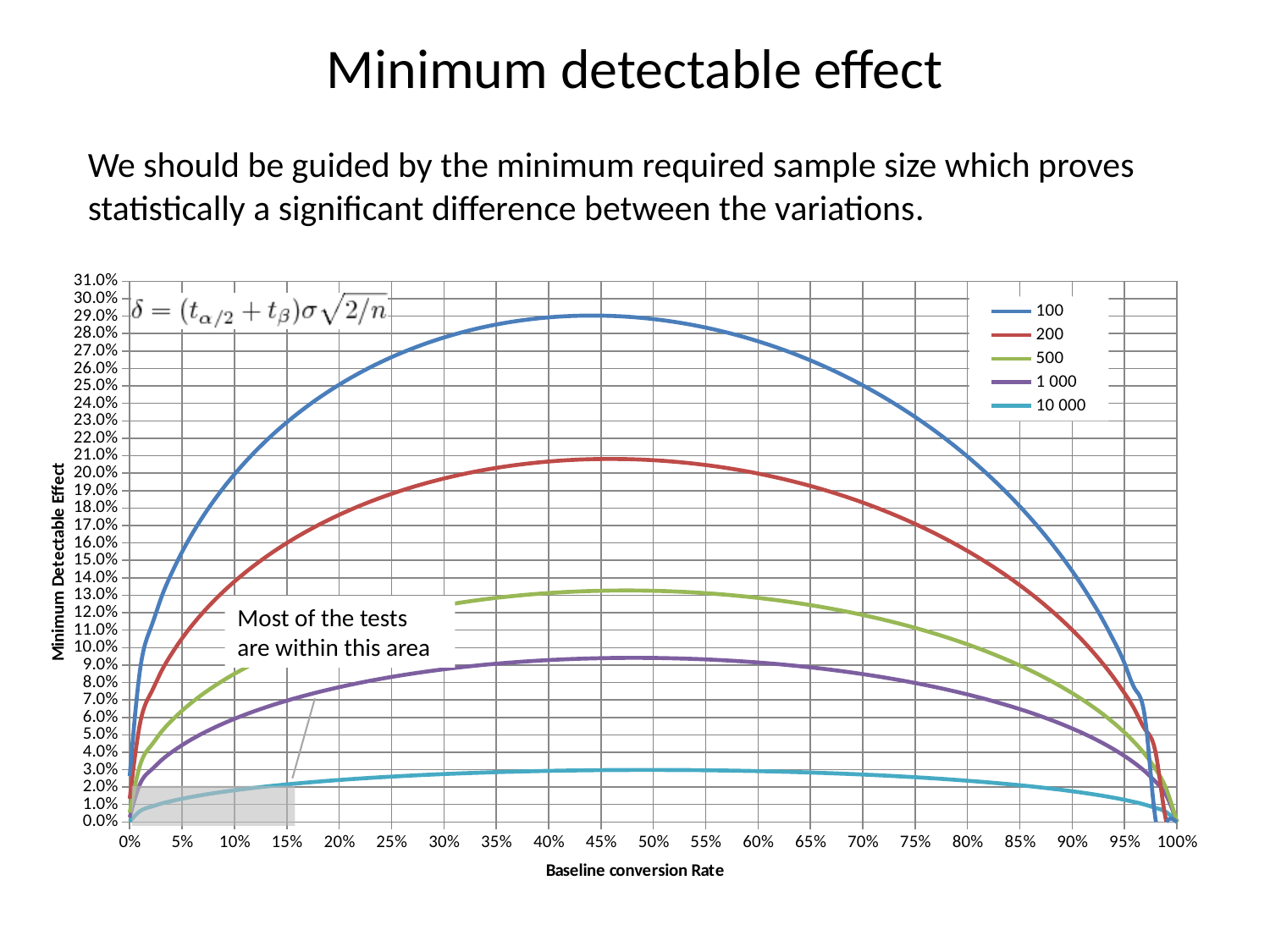
Is the value for the 200 series at a 50% baseline conversion rate greater or less than 15.0%? greater Which series reaches the highest minimum detectable effect? 100 At a 50% baseline conversion rate, which series has the larger value, 100 or 10 000? 100 Is the value for the 10 000 series at a 50% baseline conversion rate greater or less than 5.0%? less How many series does the legend list? 5 Which series has the lowest minimum detectable effect across the baseline conversion rates? 10 000 What kind of chart is shown on the slide? line chart Is the value for the 500 series at a 50% baseline conversion rate greater or less than 10.0%? greater What is the title of the y axis? Minimum Detectable Effect What is the title of the x axis? Baseline conversion Rate Do the values of the 100 series rise or fall as the baseline conversion rate goes from 0% to 45%? rise